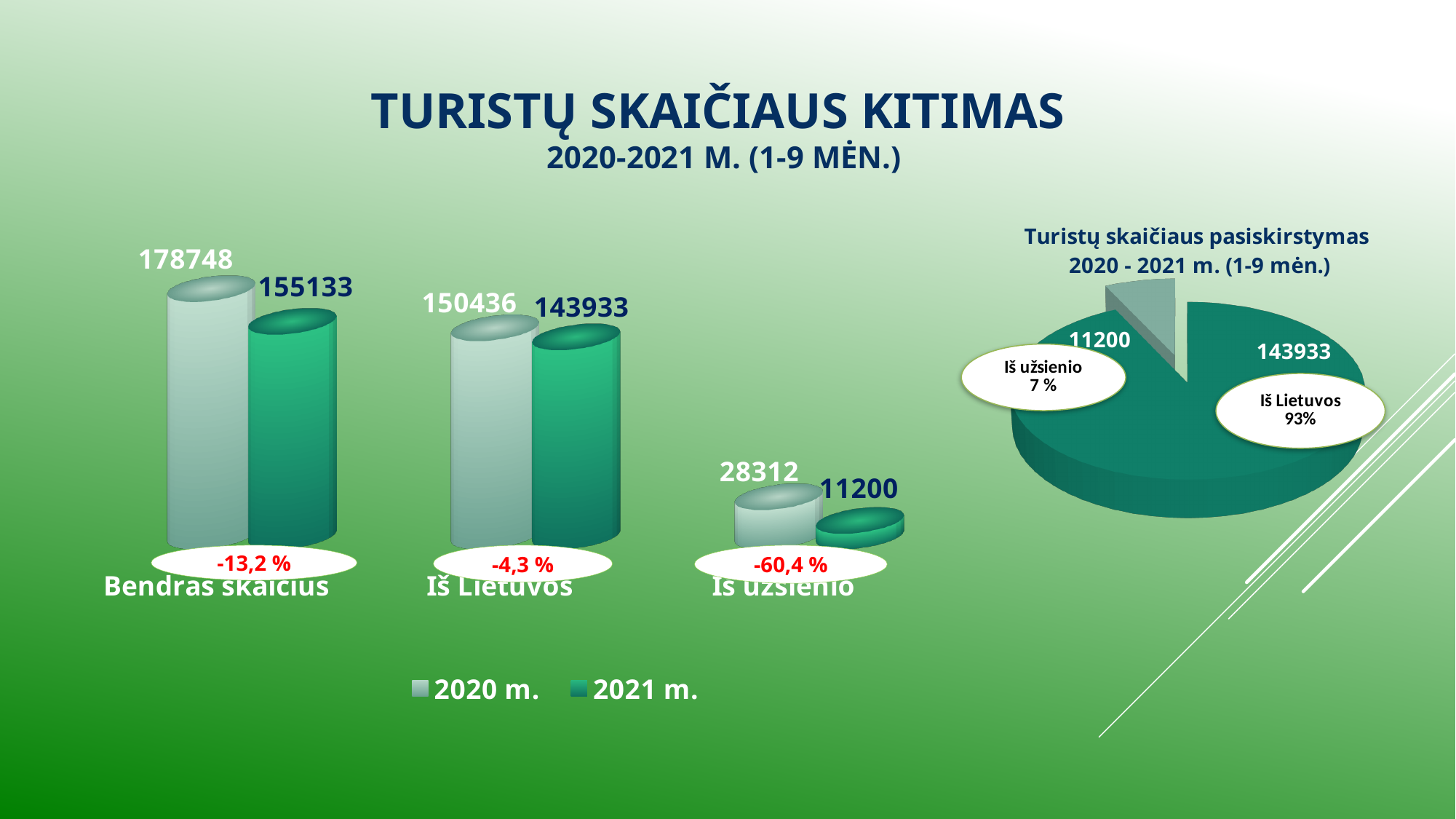
How many series does the legend of the bar chart on the left list? 2 In the bar chart on the left, what is the value for Iš Lietuvos in 2021 m.? 143933 In the bar chart on the left, which is larger for Iš Lietuvos: the 2020 m. value or the 2021 m. value? 2020 m. What kind of chart is the chart on the right of the slide? Pie chart In the bar chart on the left, what is the difference between the 2020 m. and 2021 m. values for Iš užsienio? 17112 In the bar chart on the left, what percentage change is shown for Bendras skaičius? -13,2 % In the bar chart on the left, which category has the highest value in 2021 m.? Bendras skaičius How many categories are shown in the bar chart on the left? 3 In the bar chart on the left, which category has the lowest value in 2020 m.? Iš užsienio In the bar chart on the left, what is the value for Bendras skaičius in 2020 m.? 178748 In the bar chart on the left, what is the value for Iš užsienio in 2021 m.? 11200 In the pie chart on the right, what share does Iš Lietuvos have? 93%